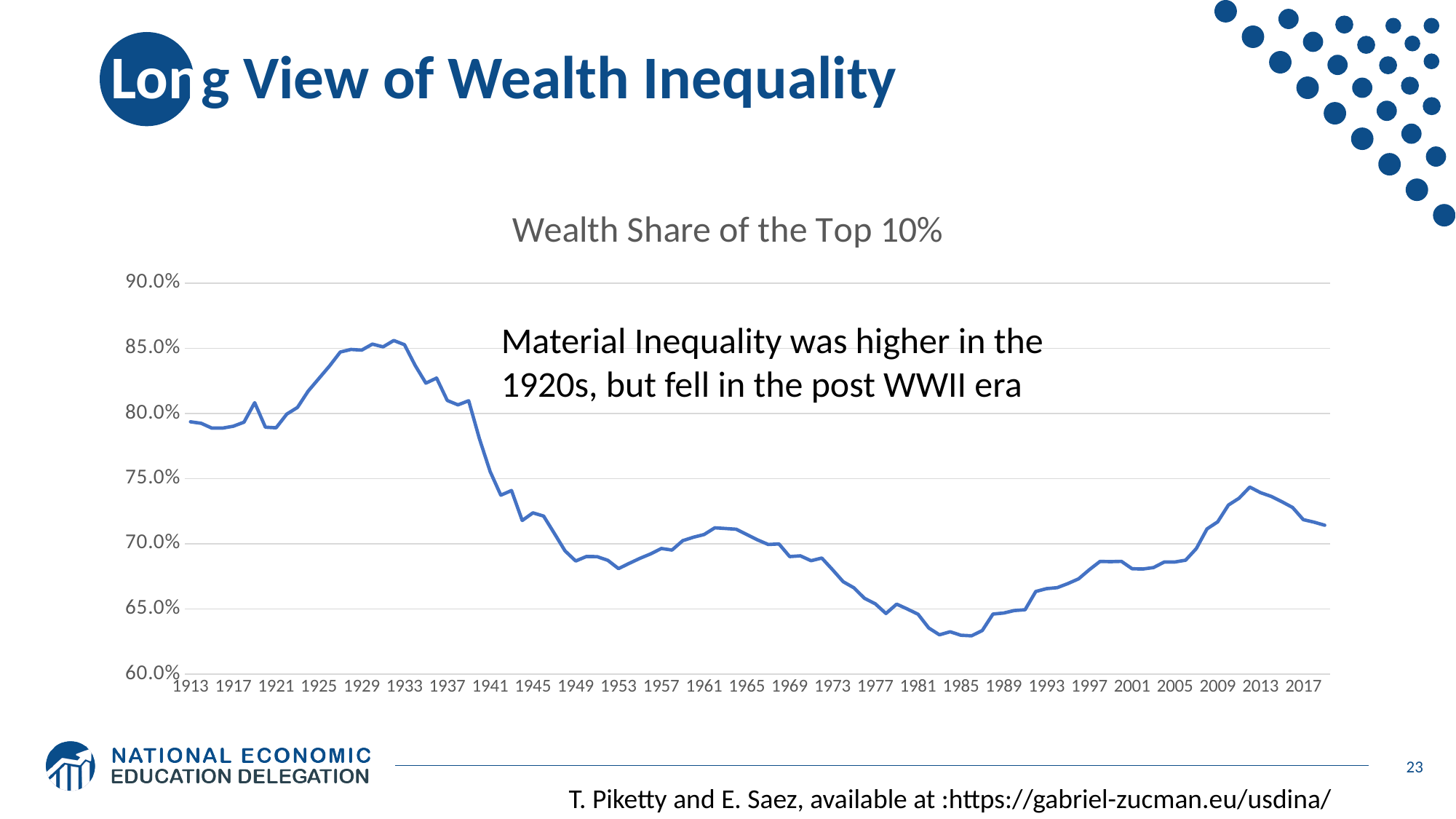
Is the value for 1913 greater or less than 80.0%? less Is the value for 2013 greater or less than 75.0%? less Does the wealth share of the top 10% rise or fall between 1933 and 1985? fall Is the value for 1985 greater or less than 65.0%? less What is the title of the chart? Wealth Share of the Top 10% What kind of chart is shown on the slide? line chart Does the wealth share of the top 10% rise or fall between 1985 and 2013? rise Which year has the larger wealth share of the top 10%, 1913 or 1985? 1913 Which year has the larger wealth share of the top 10%, 1929 or 2013? 1929